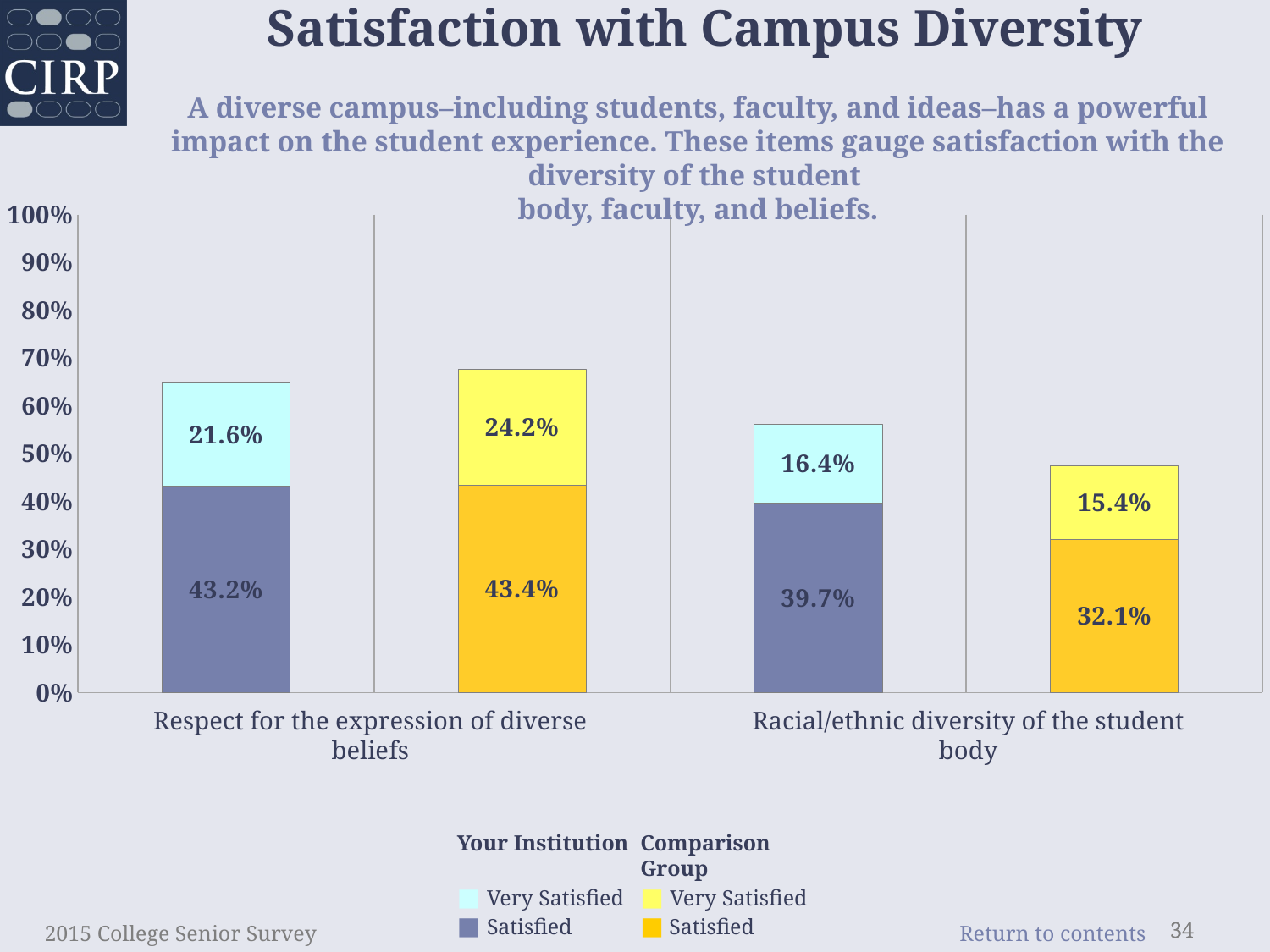
What kind of chart is shown on the slide? Stacked bar chart Which group has the larger Satisfied percentage for racial/ethnic diversity of the student body, Your Institution or the Comparison Group? Your Institution Is the total stacked bar for the Comparison Group on respect for the expression of diverse beliefs greater or less than 60%? greater What is the total percentage (Satisfied plus Very Satisfied) for the Comparison Group on racial/ethnic diversity of the student body? 47.5% What percentage of Your Institution students were Very Satisfied with respect for the expression of diverse beliefs? 21.6% How many categories are shown on the x axis of the chart? 2 What is the total percentage (Satisfied plus Very Satisfied) for Your Institution on respect for the expression of diverse beliefs? 64.8% What percentage of Your Institution students were Satisfied with racial/ethnic diversity of the student body? 39.7% What is the difference between the Comparison Group's and Your Institution's Very Satisfied percentages for respect for the expression of diverse beliefs? 2.6% What is the title of the chart on the slide? Satisfaction with Campus Diversity What percentage of the Comparison Group were Satisfied with racial/ethnic diversity of the student body? 32.1% How many series does the legend list? 4